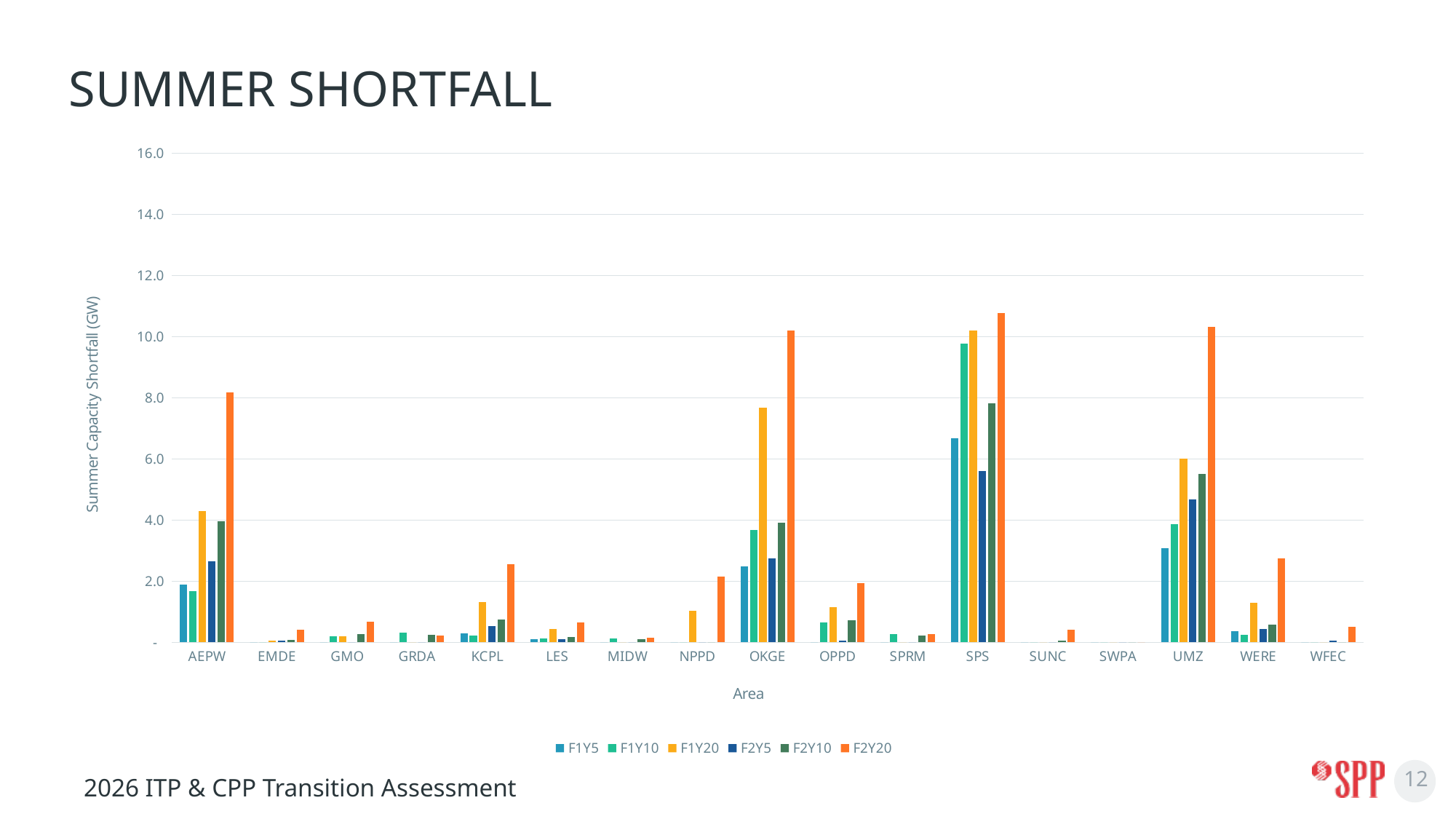
Is the F1Y10 value for SPS greater or less than 8.0? greater Which is larger, the F2Y20 value for AEPW or the F2Y20 value for WERE? AEPW What is the label of the y axis? Summer Capacity Shortfall (GW) What kind of chart is shown on the slide? bar chart Which area has the highest F1Y20 value? SPS Is the F2Y20 value for KCPL greater or less than 4.0? less Which is larger, the F1Y20 value for SPS or the F1Y20 value for UMZ? SPS How many series does the legend list? 6 How many areas are shown along the x axis? 17 Is the F1Y20 value for OKGE greater or less than 6.0? greater Which area has the highest F1Y5 value? SPS